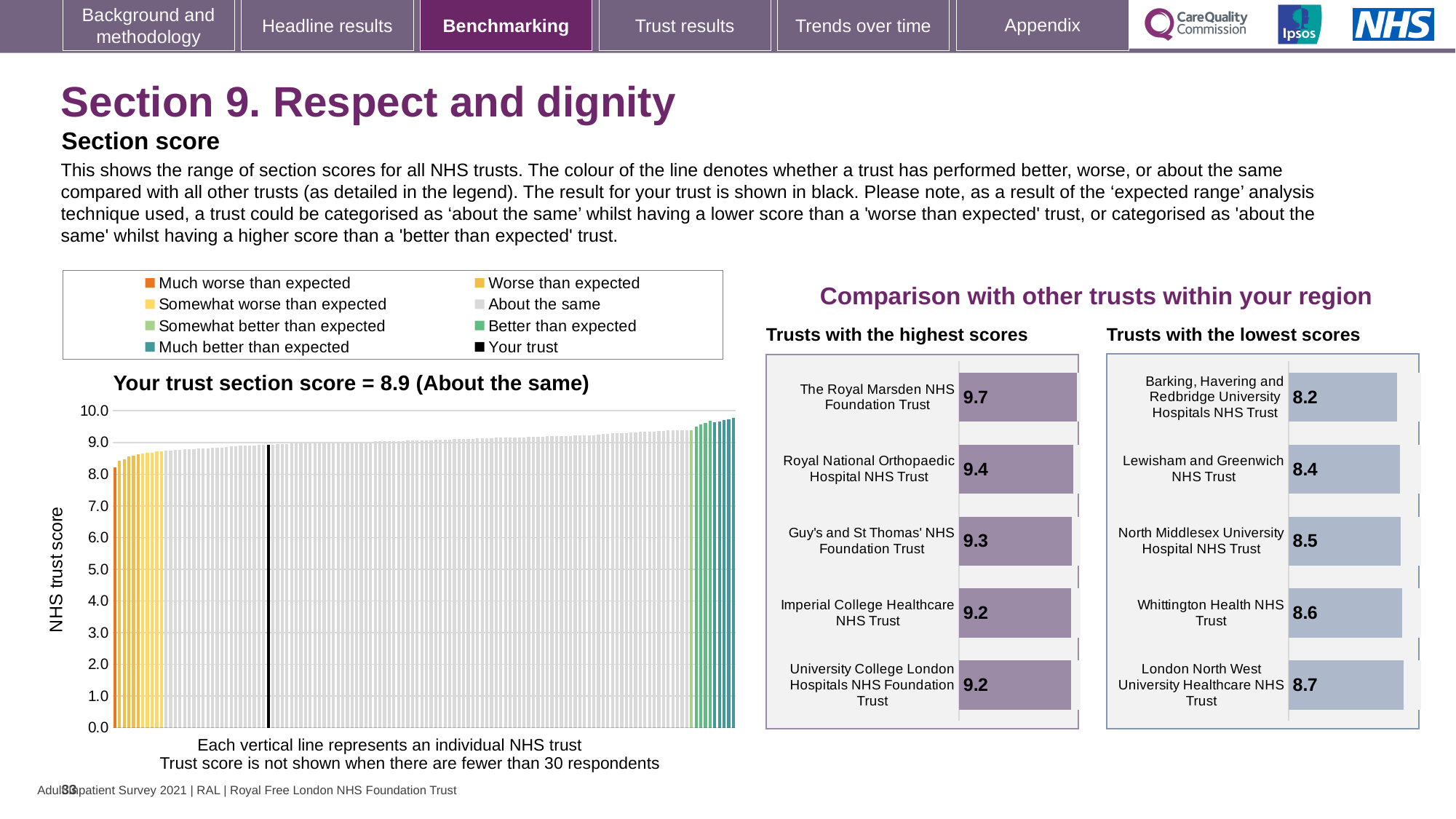
What kind of chart is the 'Trusts with the lowest scores' chart? Bar chart In the 'Trusts with the highest scores' chart, which trust has the highest score? The Royal Marsden NHS Foundation Trust In the 'Trusts with the highest scores' chart, what is the score for The Royal Marsden NHS Foundation Trust? 9.7 In the main chart on the left, what is your trust's section score? 8.9 In the 'Trusts with the lowest scores' chart, what is the score for Barking, Havering and Redbridge University Hospitals NHS Trust? 8.2 In the 'Trusts with the highest scores' chart, what is the difference between the scores of The Royal Marsden NHS Foundation Trust and Royal National Orthopaedic Hospital NHS Trust? 0.3 In the 'Trusts with the lowest scores' chart, which trust has the lowest score? Barking, Havering and Redbridge University Hospitals NHS Trust In the 'Trusts with the lowest scores' chart, which has the higher score: Lewisham and Greenwich NHS Trust or North Middlesex University Hospital NHS Trust? North Middlesex University Hospital NHS Trust How many entries does the legend above the main chart on the left list? 8 What is the y-axis label of the main chart on the left? NHS trust score How many trusts are shown in the 'Trusts with the highest scores' chart? 5 In the 'Trusts with the lowest scores' chart, what is the difference between the scores of London North West University Healthcare NHS Trust and Barking, Havering and Redbridge University Hospitals NHS Trust? 0.5